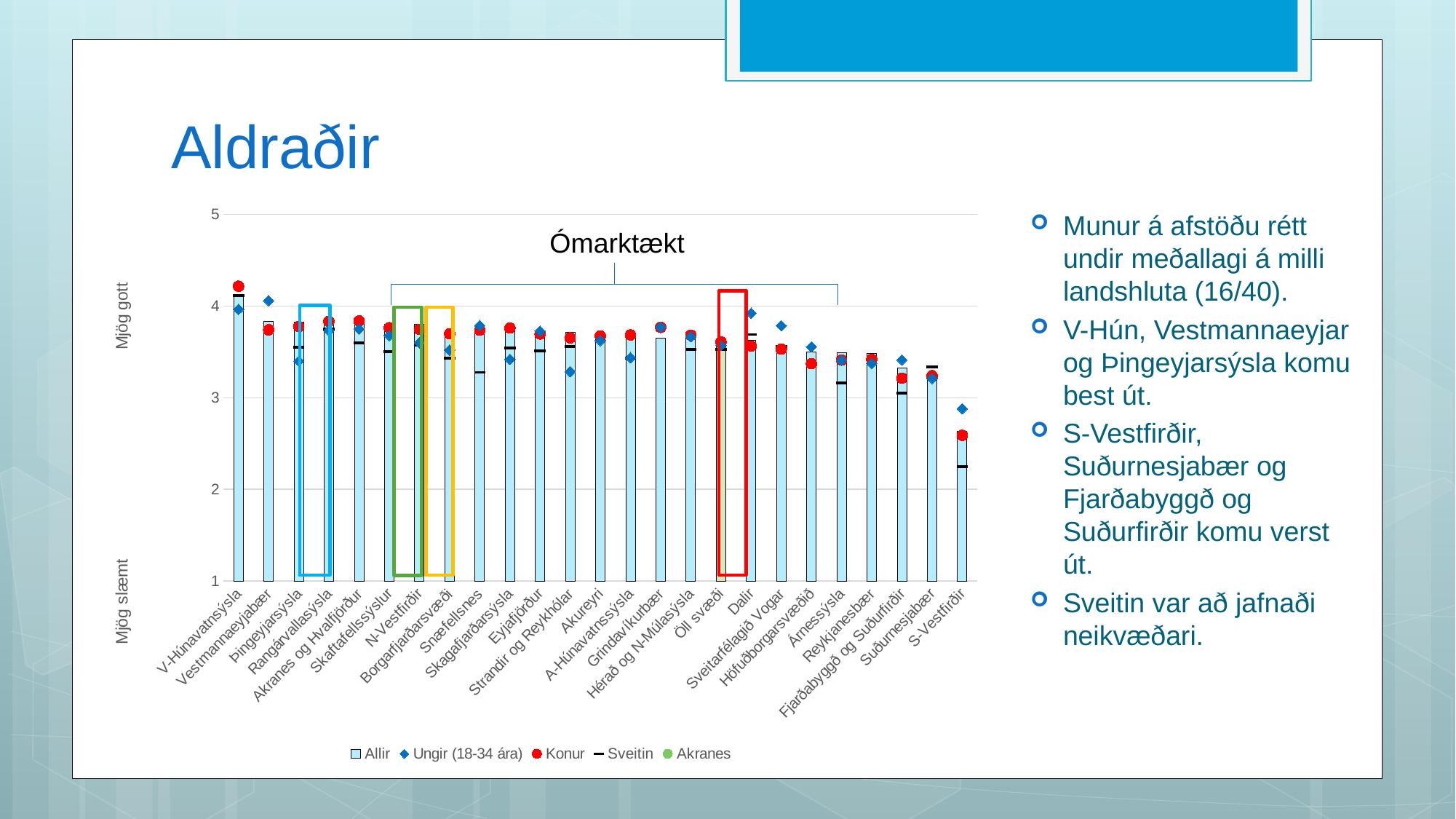
What label is written above the bracket spanning the middle categories of the chart? Ómarktækt Do the Allir values generally rise or fall from left to right along the x axis? fall Is the Allir value for V-Húnavatnsýsla greater or less than 4? greater Is the Allir value for S-Vestfirðir greater or less than 3? less What kind of chart is shown on the slide? bar chart Which category has the lowest value for the Allir series? S-Vestfirðir How many series does the legend list? 5 How many categories are shown on the x axis? 25 Which category has the highest value for the Allir series? V-Húnavatnsýsla Which has the larger Allir value, V-Húnavatnsýsla or S-Vestfirðir? V-Húnavatnsýsla Is the Konur value for V-Húnavatnsýsla greater or less than 4? greater